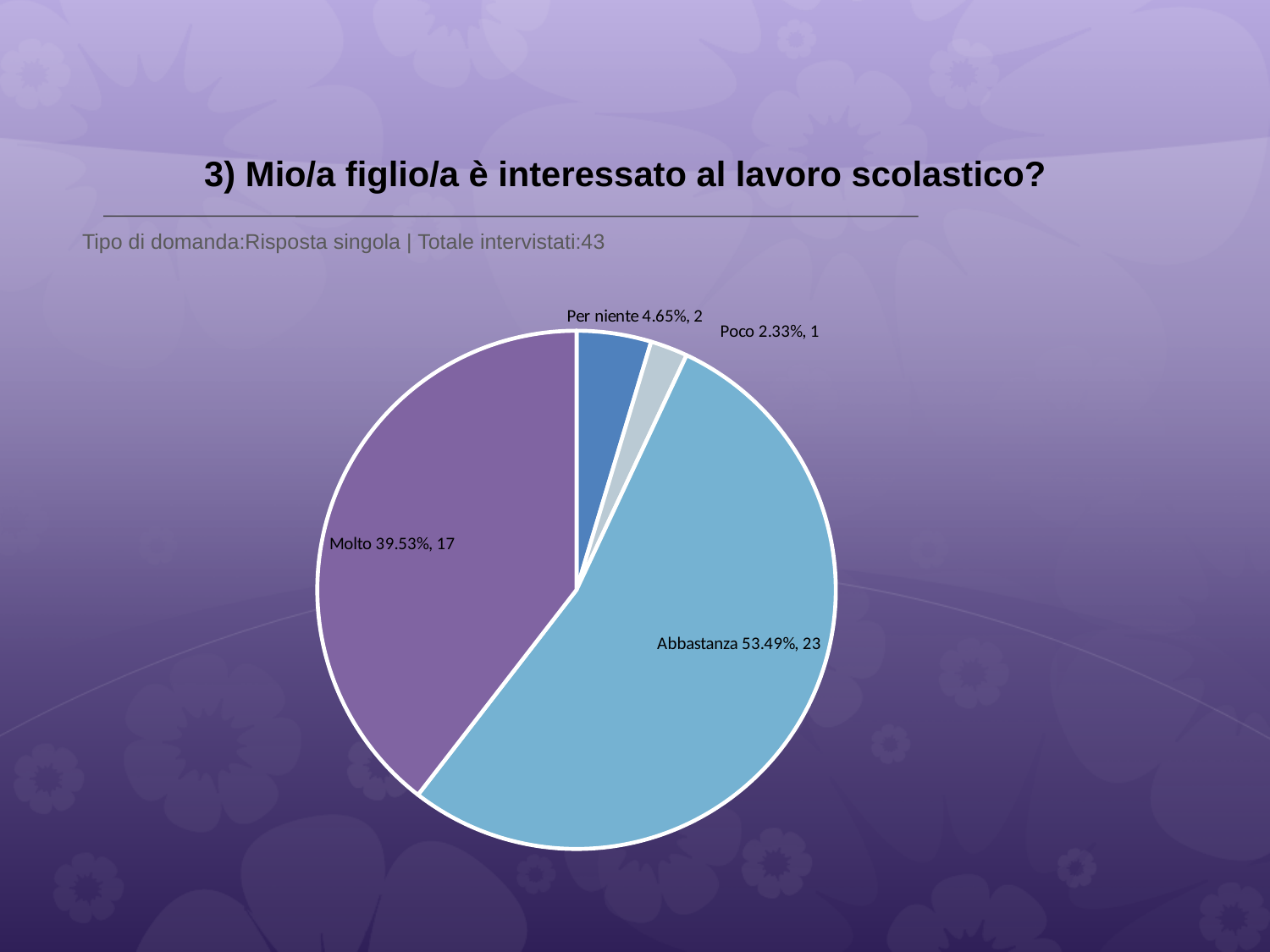
Which category has the smallest slice of the pie? Poco How many respondents answered Per niente? 2 What share of the pie does the Molto slice represent? 39.53% What kind of chart is shown on the slide? pie chart What is the total number of respondents shown on the slide? 43 Which category has the largest slice of the pie? Abbastanza Which slice is larger, Per niente or Poco? Per niente How many respondents answered Poco? 1 What share of the pie does the Abbastanza slice represent? 53.49% What is the difference in respondent count between Abbastanza and Molto? 6 How many slices does the pie chart have? 4 How many respondents answered Molto? 17